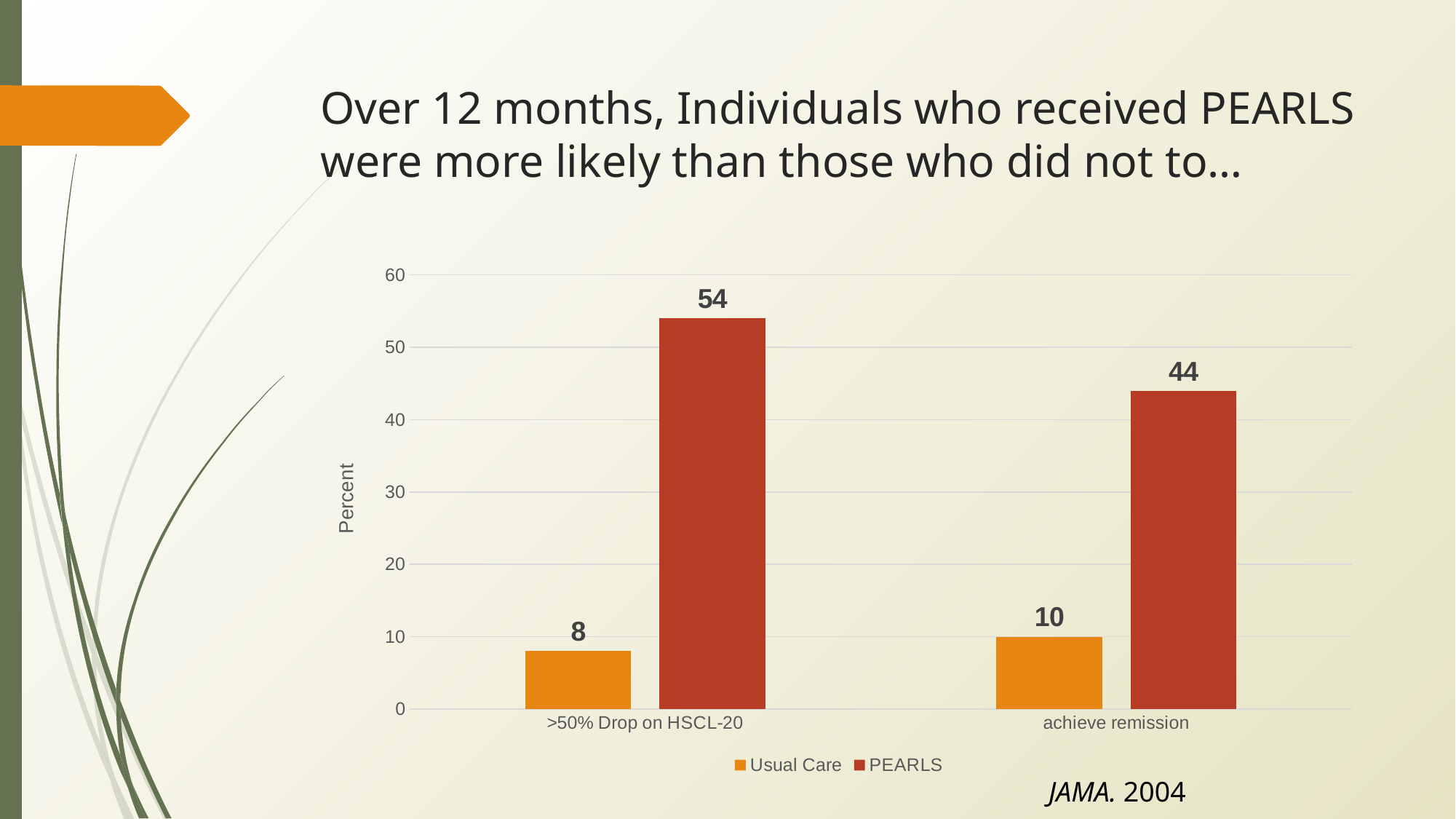
What is the value for Usual Care in the "achieve remission" category? 10 How many categories are shown on the x axis? 2 Which bar has the highest value on the chart? PEARLS, >50% Drop on HSCL-20 What is the value for PEARLS in the "achieve remission" category? 44 What is the value for PEARLS in the ">50% Drop on HSCL-20" category? 54 What is the difference between the PEARLS and Usual Care values in the ">50% Drop on HSCL-20" category? 46 What is the difference between the PEARLS and Usual Care values in the "achieve remission" category? 34 Which is larger: the PEARLS value for ">50% Drop on HSCL-20" or the PEARLS value for "achieve remission"? >50% Drop on HSCL-20 What is the value for Usual Care in the ">50% Drop on HSCL-20" category? 8 Which bar has the lowest value on the chart? Usual Care, >50% Drop on HSCL-20 How many series does the legend list? 2 What type of chart is shown on the slide? Bar chart